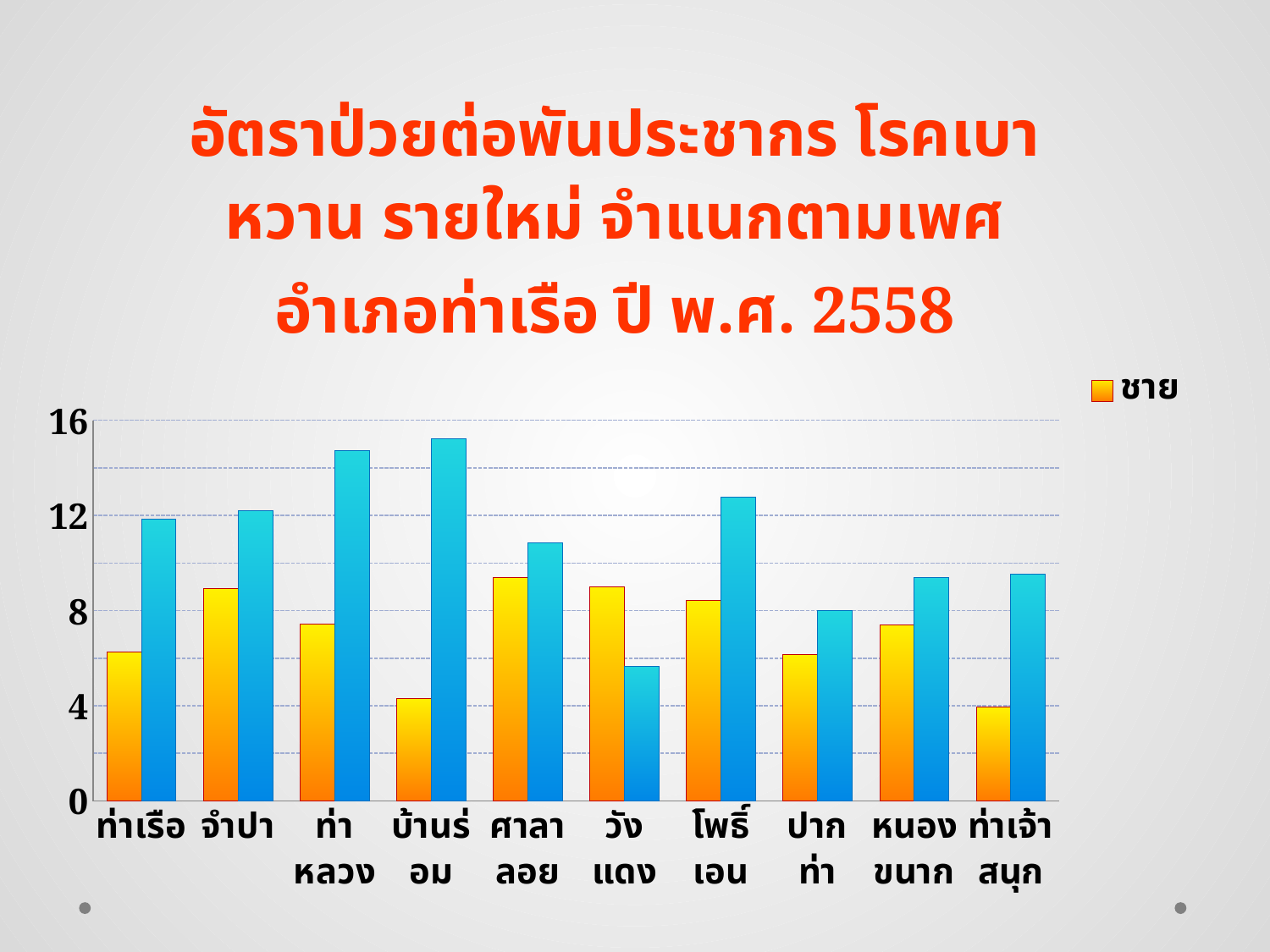
Is the ชาย value for ศาลาลอย greater or less than 8? greater Which year (พ.ศ.) is given in the chart title? 2558 Is the blue-series value for วังแดง greater or less than 8? less Which category has the lowest value for the blue series? วังแดง For วังแดง, which is larger: the ชาย bar or the blue bar? the ชาย bar Which series name is shown in the legend? ชาย Is the ชาย value for ท่าเรือ greater or less than 8? less For ท่าเรือ, which is larger: the ชาย bar or the blue bar? the blue bar How many categories (sub-districts) are shown on the x axis? 10 What kind of chart is shown on the slide? bar chart